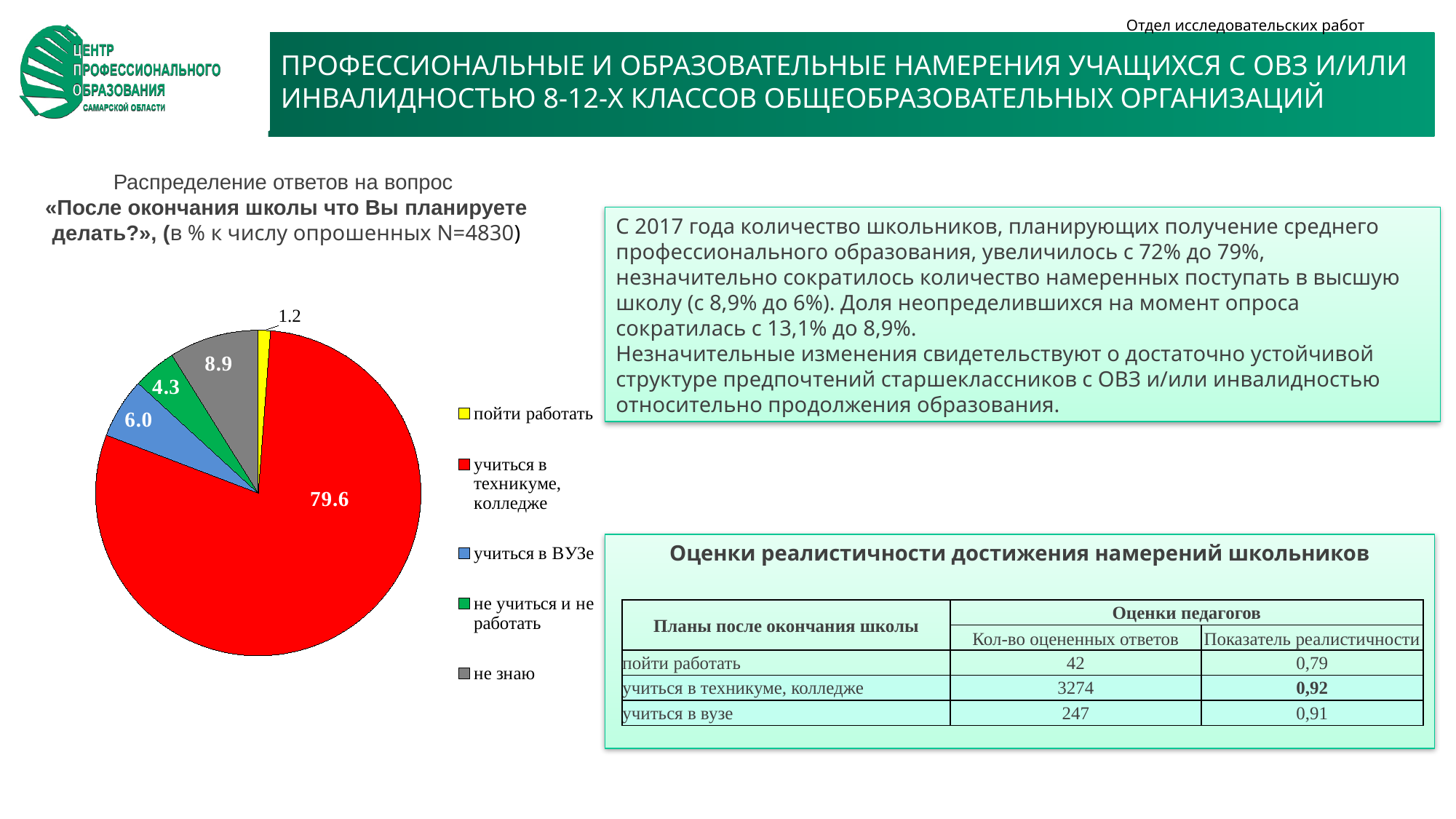
What is the value for «не знаю» in the pie chart? 8.9 What kind of chart is shown on the slide? pie chart What is the value for «не учиться и не работать» in the pie chart? 4.3 Which category has the largest slice in the pie chart? учиться в техникуме, колледже Which is larger in the pie chart: «учиться в ВУЗе» or «не учиться и не работать»? учиться в ВУЗе How many slices does the pie chart have? 5 Which category has the smallest slice in the pie chart? пойти работать What is the value for «учиться в техникуме, колледже» in the pie chart? 79.6 What is the value for «пойти работать» in the pie chart? 1.2 What is the value for «учиться в ВУЗе» in the pie chart? 6.0 What is the difference between the values for «не знаю» and «учиться в ВУЗе» in the pie chart? 2.9 What colour is the slice for «не знаю» in the pie chart? grey